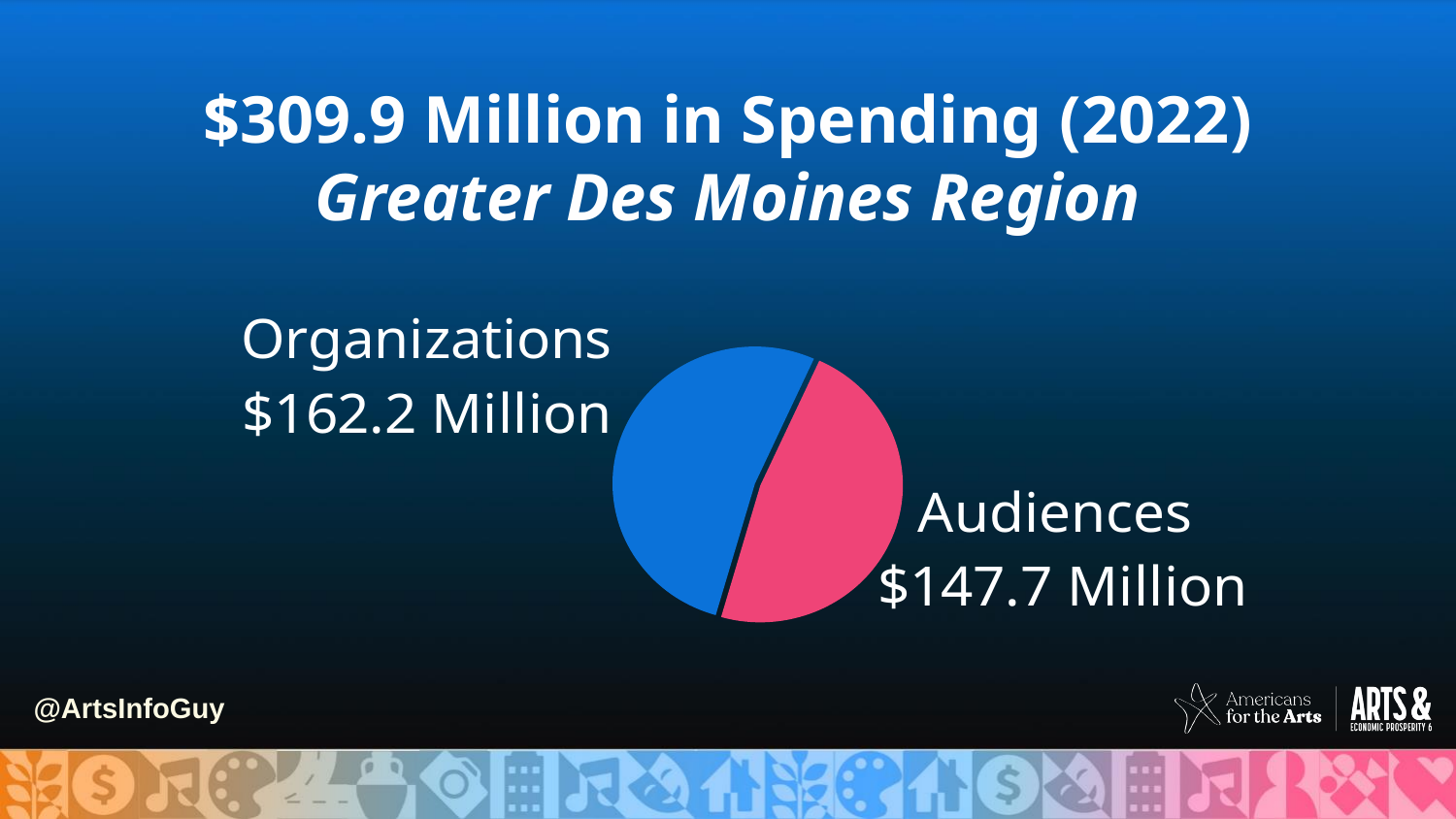
How many slices does the pie chart have? 2 Which category has the smaller share of spending in the pie chart? Audiences What is the total spending represented by the pie chart? $309.9 Million What percentage of total spending does the Organizations slice represent, to one decimal place? 52.3% What is the spending value for Audiences in the pie chart? $147.7 Million What is the spending value for Organizations in the pie chart? $162.2 Million Which category has the larger share of spending in the pie chart? Organizations How much more spending is attributed to Organizations than to Audiences? $14.5 Million Is spending by Audiences larger or smaller than spending by Organizations? Smaller Which region does the slide title say the spending figures are for? Greater Des Moines Region What kind of chart is shown on the slide? Pie chart What colour is the Organizations slice of the pie chart? Blue